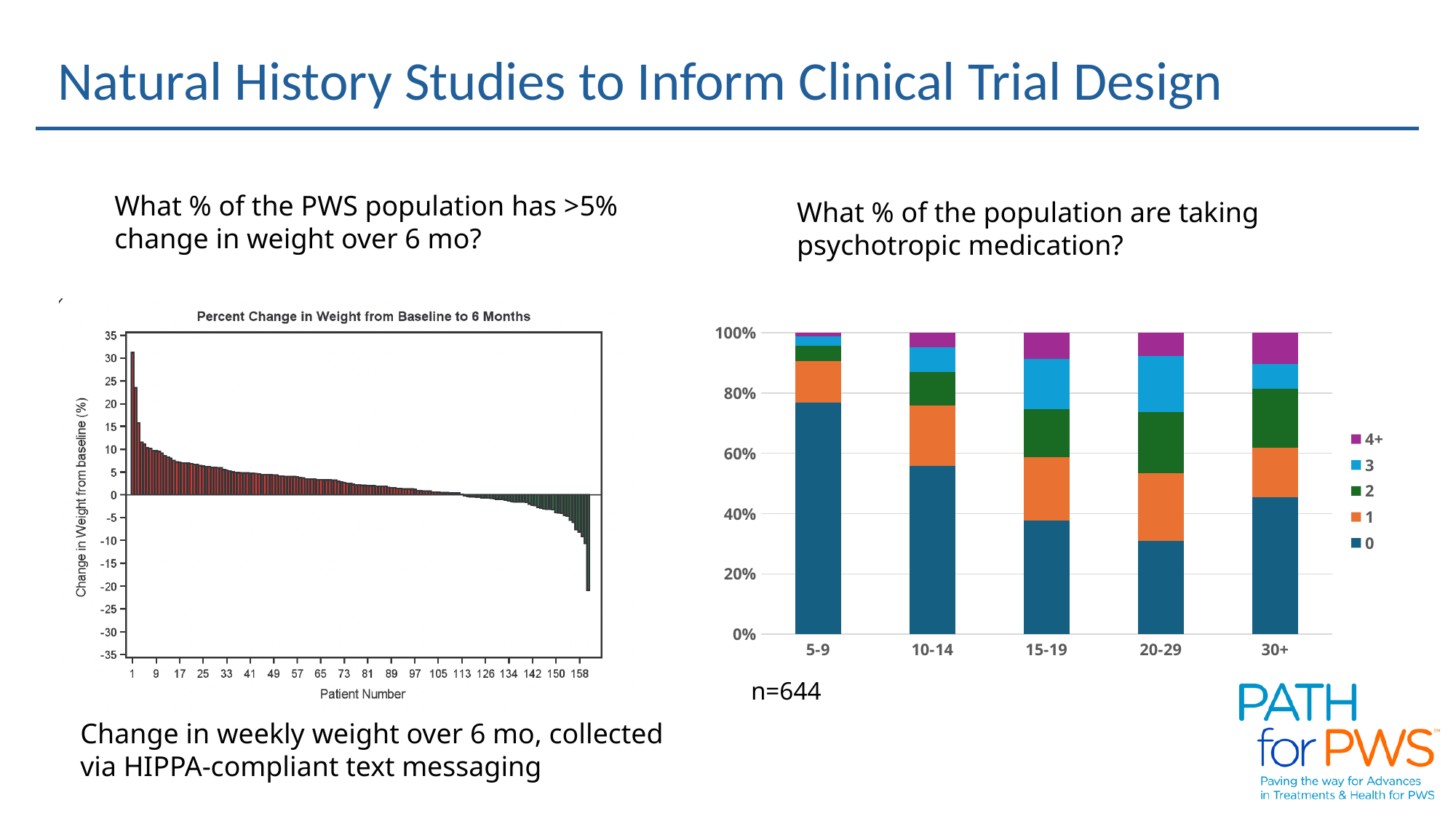
In the left chart 'Percent Change in Weight from Baseline to 6 Months', what is the label of the x axis? Patient Number In the right chart, is the '0' share for the 5-9 age group greater or less than 60%? greater In the left chart 'Percent Change in Weight from Baseline to 6 Months', is the value for patient 1 greater or less than 25? greater In the left chart 'Percent Change in Weight from Baseline to 6 Months', do the values rise or fall as the patient number increases along the x axis? fall How many age-group categories are shown on the x axis of the right chart? 5 What type of chart is the left chart titled 'Percent Change in Weight from Baseline to 6 Months'? bar chart In the right chart, is the '0' share for the 20-29 age group greater or less than 40%? less How many series does the legend of the right chart list? 5 In the right chart, which age group has the smallest share in the '0' series? 20-29 In the right chart, which age group has a larger '0' share, 5-9 or 30+? 5-9 In the right chart, which age group has the largest share in the '0' series? 5-9 What type of chart is the right chart showing psychotropic medication by age group? stacked bar chart